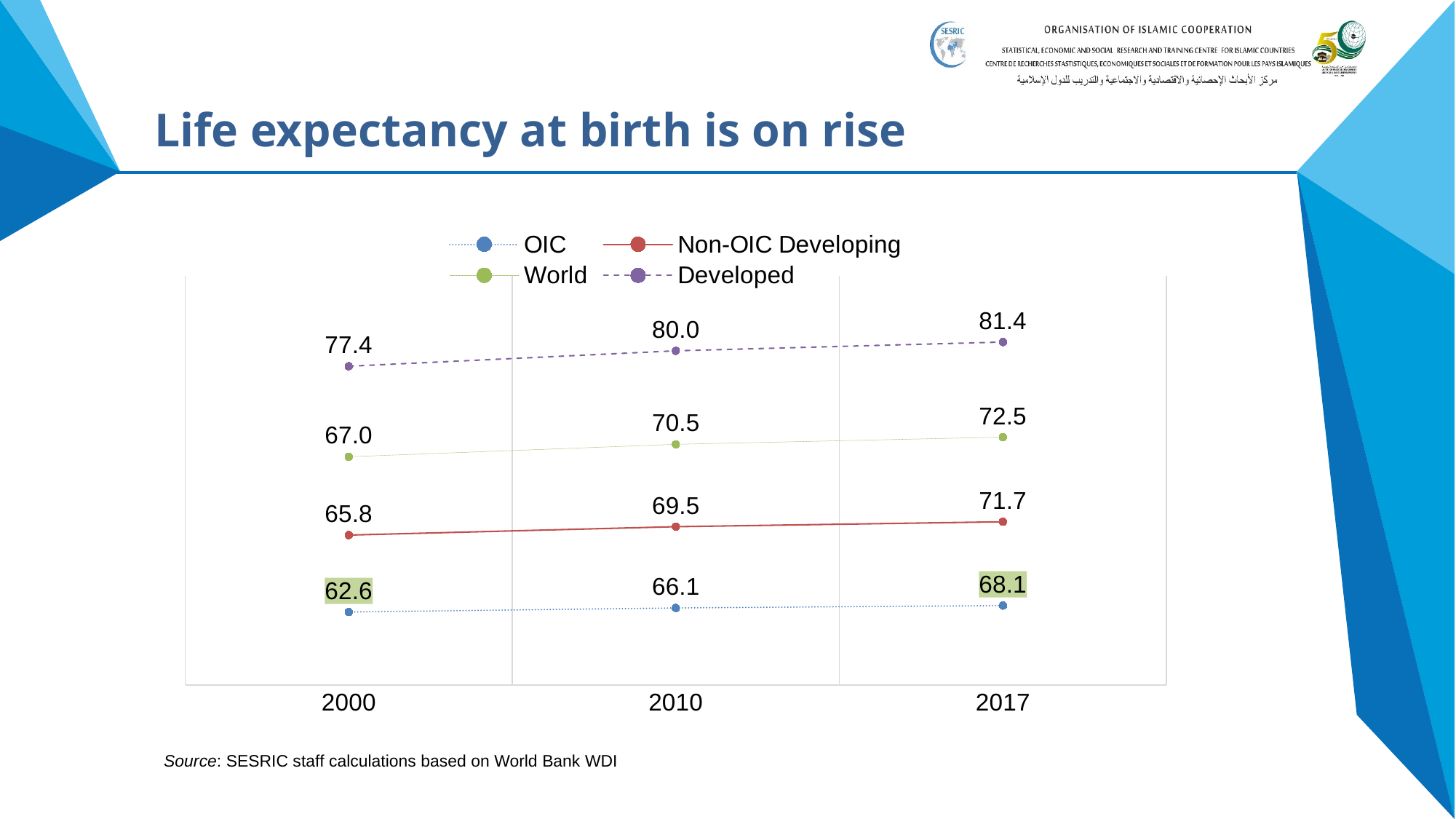
How many series does the legend list? 4 What is the value for World in 2010? 70.5 What is the value for Developed in 2000? 77.4 What is the difference between the Developed and OIC values in 2010? 13.9 By how much did the OIC value increase from 2000 to 2017? 5.5 Which series has the lowest value in 2000? OIC Which series has the highest value in 2017? Developed What is the value for Non-OIC Developing in 2017? 71.7 Does the OIC series rise or fall from 2000 to 2017? Rise What is the life expectancy value for OIC in 2017? 68.1 What kind of chart is shown on the slide? Line chart In 2010, which is larger: the World value or the Non-OIC Developing value? World